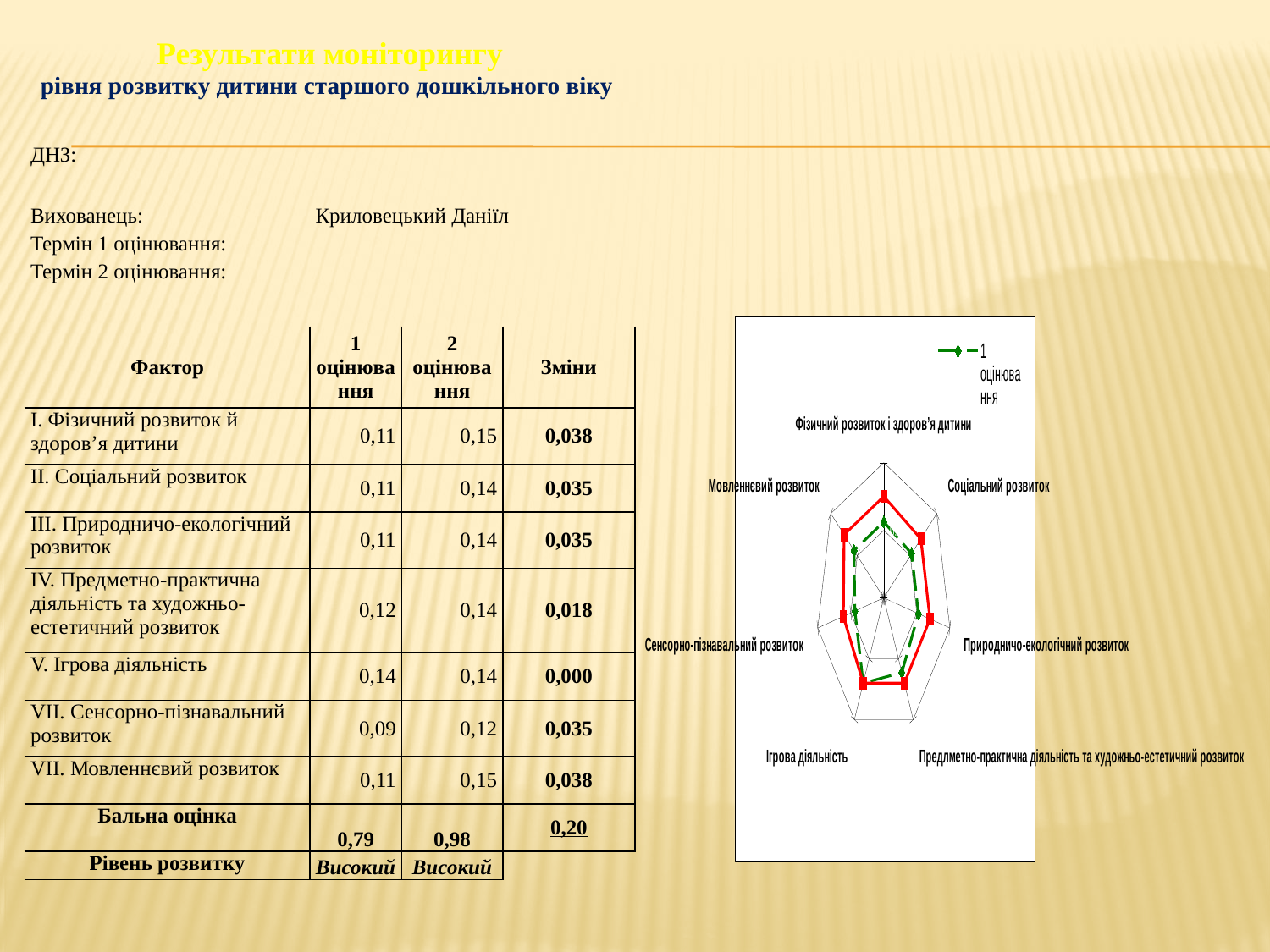
What kind of chart is shown on the right side of the slide? radar chart How many categories (axes) does the radar chart have? 7 On the radar chart, what colour is the line for the legend entry "1 оцінювання"? green On the radar chart, which category label is placed at the top of the chart? Фізичний розвиток і здоров'я дитини On the radar chart, which series lies further from the centre on every axis, the solid red line or the dashed green line? the solid red line